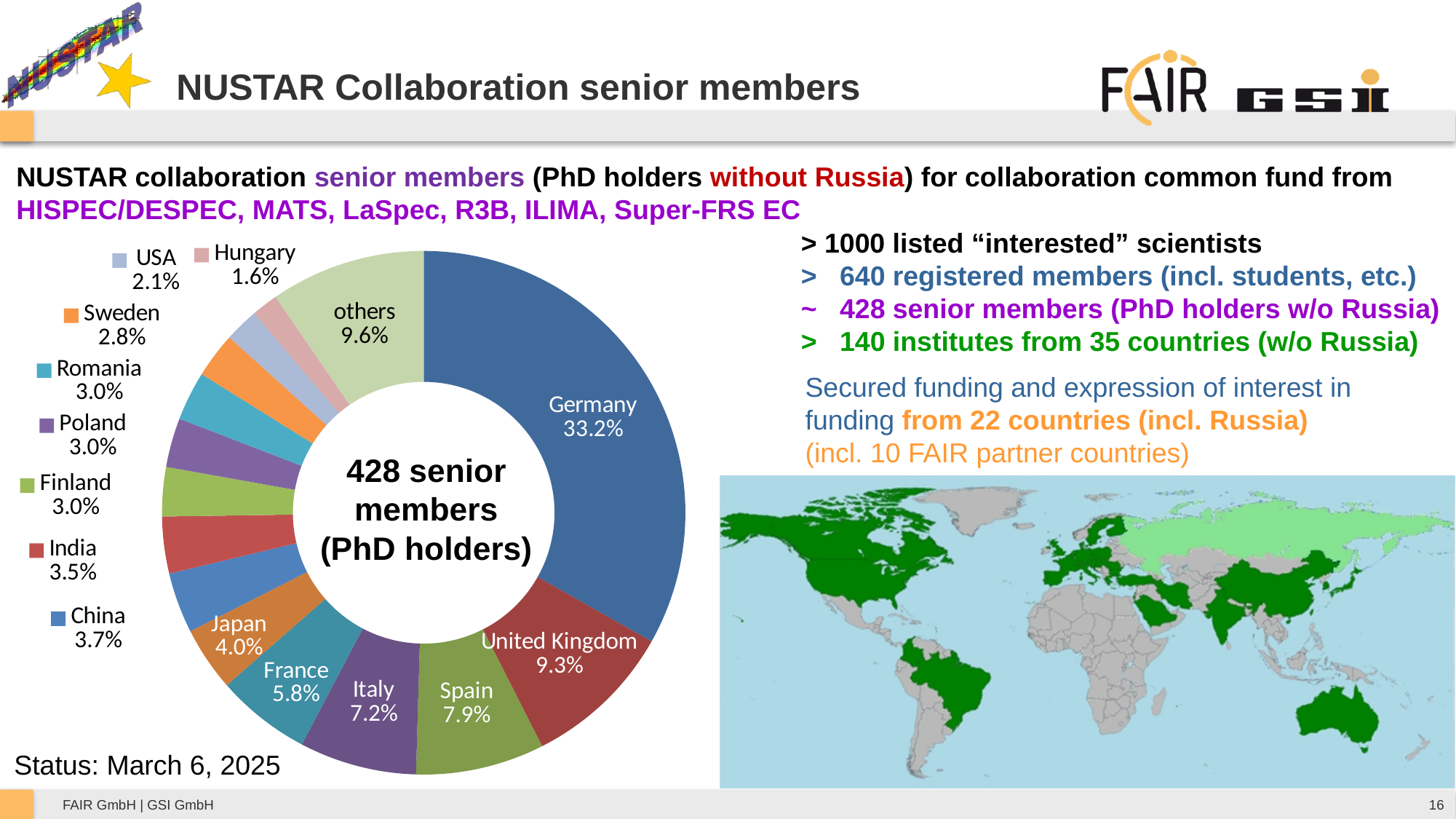
What percentage does the 'others' slice represent? 9.6% What is the difference in percentage points between Germany's and the United Kingdom's shares? 23.9 What text is written in the centre of the pie chart? 428 senior members (PhD holders) What is the difference in percentage points between Spain's and Italy's shares? 0.7 How many slices does the pie chart have, including 'others'? 15 What type of chart is used to show the senior members by country? Doughnut chart Which labelled country has the smallest share of senior members? Hungary What share of the senior members is from Japan? 4.0% Which has a larger share of senior members, France or China? France What share of the senior members is from the United Kingdom? 9.3% What share of the senior members is from Germany? 33.2% Which country has the largest share of senior members? Germany